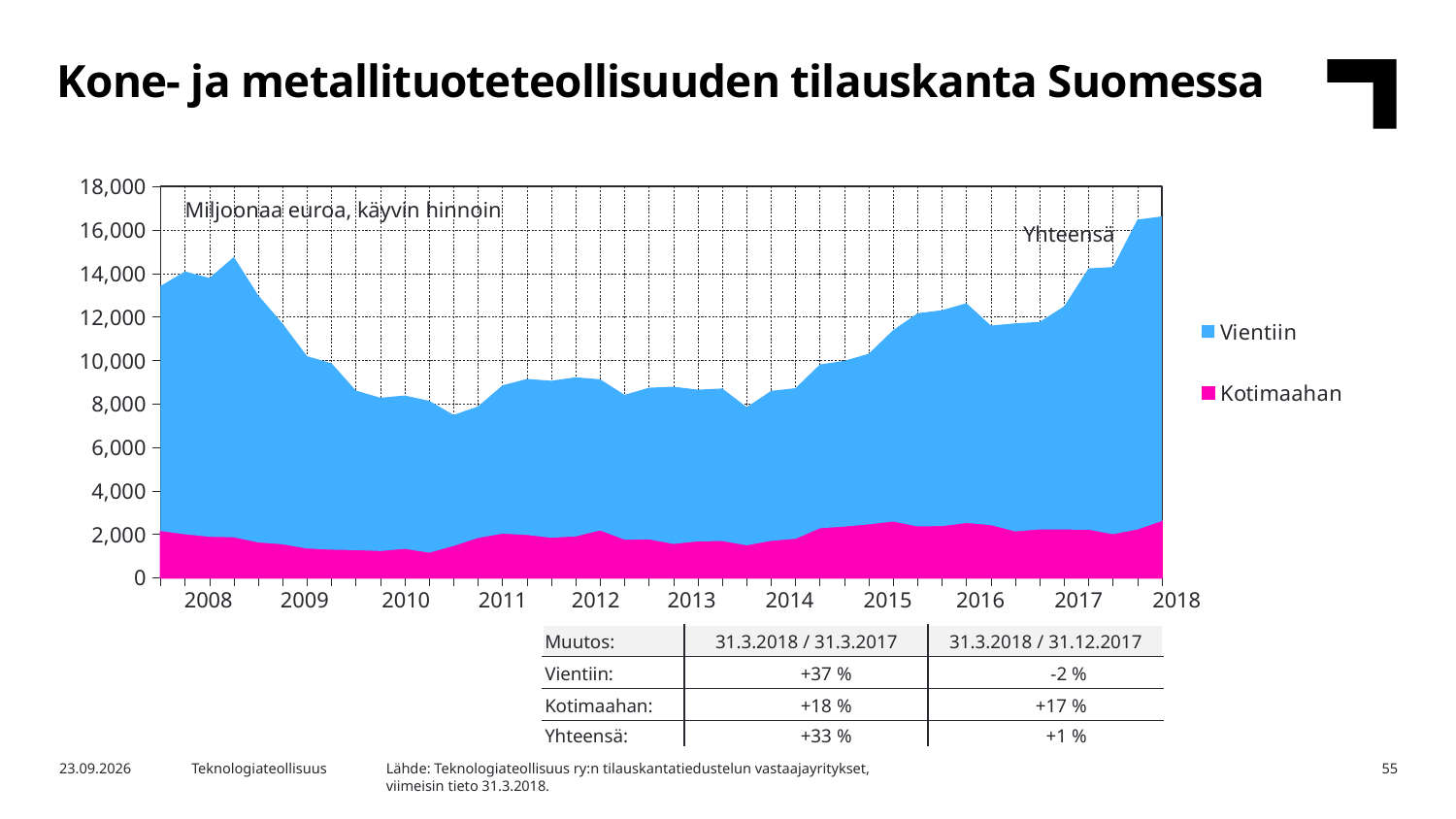
Is the Kotimaahan value at the end of the series in 2018 greater or less than 2,000? greater Which is larger, the total order book at the start of 2008 or at the start of 2013? 2008 What unit is stated in the annotation inside the chart area? Miljoonaa euroa, käyvin hinnoin Is the total (Yhteensä) value at the end of the series in 2018 greater or less than 14,000? greater Does the total order book rise or fall between 2008 and 2010? fall How many series does the chart legend list? 2 Is the Kotimaahan value at the start of 2010 greater or less than 2,000? less What are the two series named in the chart legend? Vientiin and Kotimaahan How many year labels are shown on the x axis? 11 What type of chart is shown on the slide? Stacked area chart